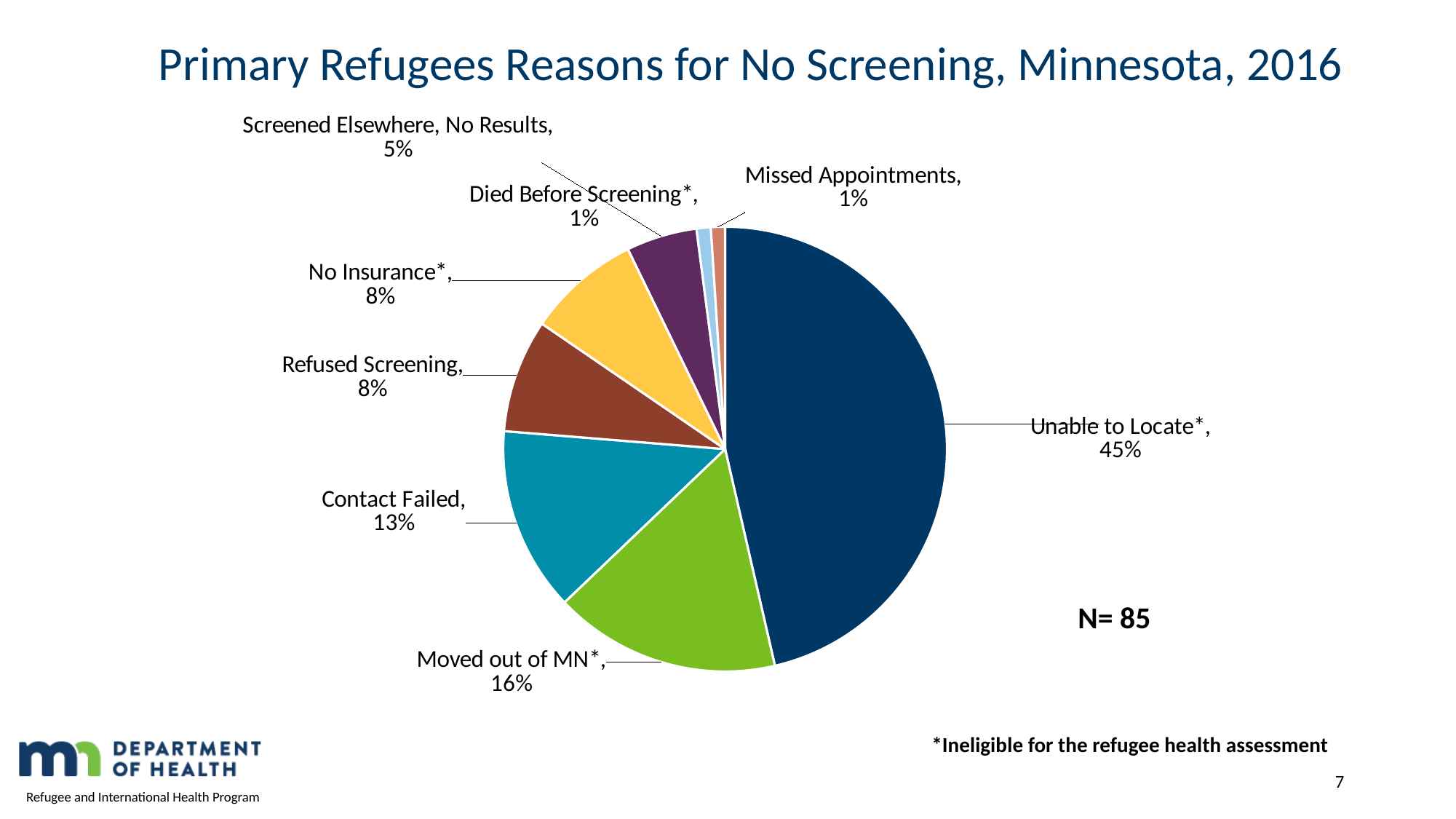
Which reason has the largest slice of the pie? Unable to Locate What is the title of the chart? Primary Refugees Reasons for No Screening, Minnesota, 2016 What is the difference in percentage points between Moved out of MN and Contact Failed? 3 What percentage is shown for Missed Appointments? 1% What is the total N shown on the slide? N= 85 What percentage is shown for Moved out of MN? 16% What share of the pie is Unable to Locate? 45% What percentage is shown for Contact Failed? 13% How many slices does the pie chart have? 8 What percentage is shown for Screened Elsewhere, No Results? 5% Which is larger, the share for No Insurance or the share for Contact Failed? Contact Failed What kind of chart is shown on the slide? pie chart